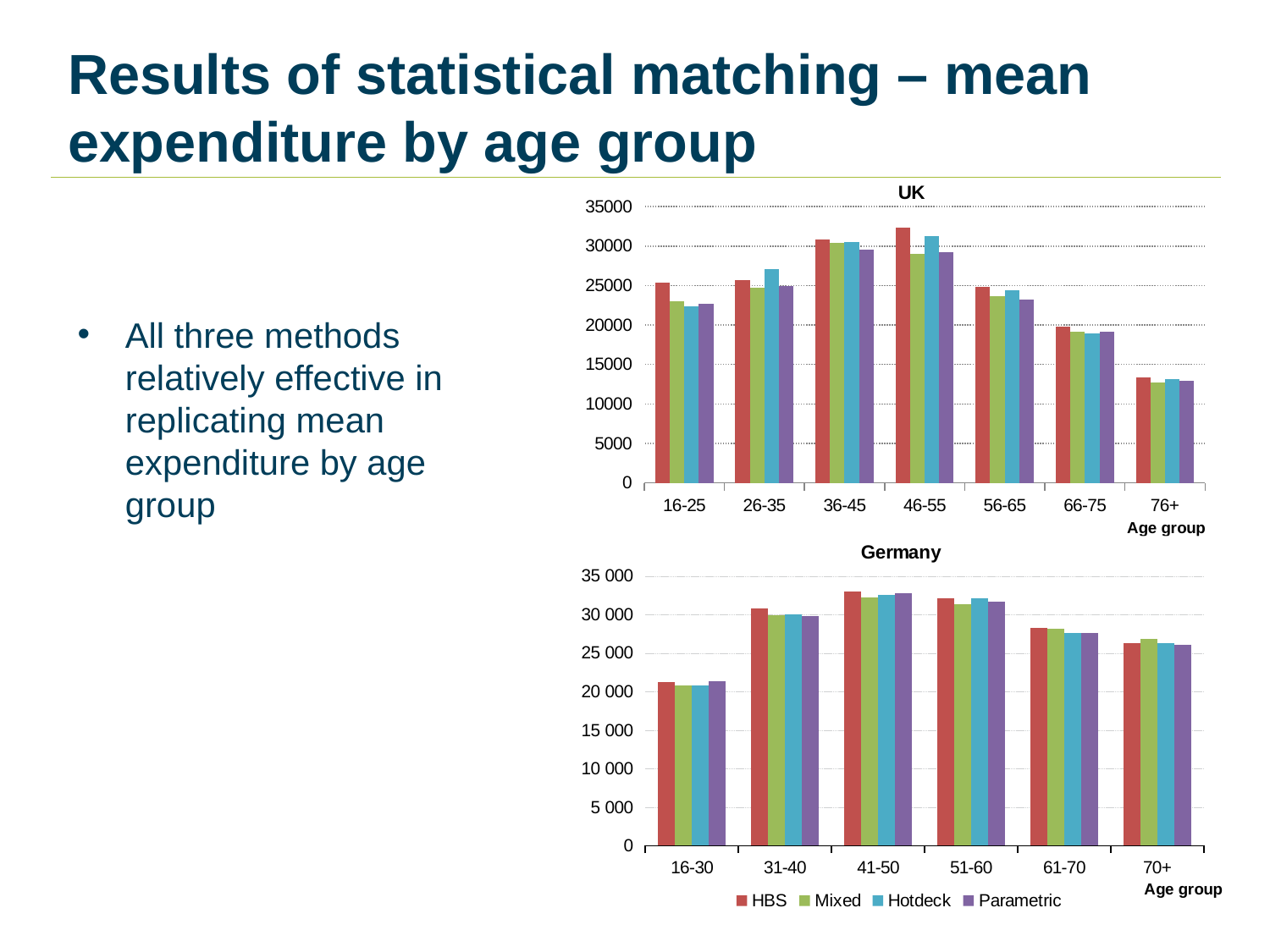
What type of chart is the UK chart? bar chart In the UK chart, which is larger: the HBS value for 36-45 or for 56-65? 36-45 In the UK chart, is the HBS value for the 76+ age group greater or less than 15000? less In the Germany chart, is the HBS value for the 41-50 age group greater or less than 30 000? greater How many age groups are shown on the x axis of the UK chart? 7 In the UK chart, is the HBS value for the 46-55 age group greater or less than 30000? greater In the UK chart, which age group has the highest HBS value? 46-55 In the UK chart, which age group has the lowest HBS value? 76+ In the Germany chart, which age group has the lowest HBS value? 16-30 Which series is shown in red in the legend? HBS How many series does the legend list for the charts? 4 How many age groups are shown on the x axis of the Germany chart? 6